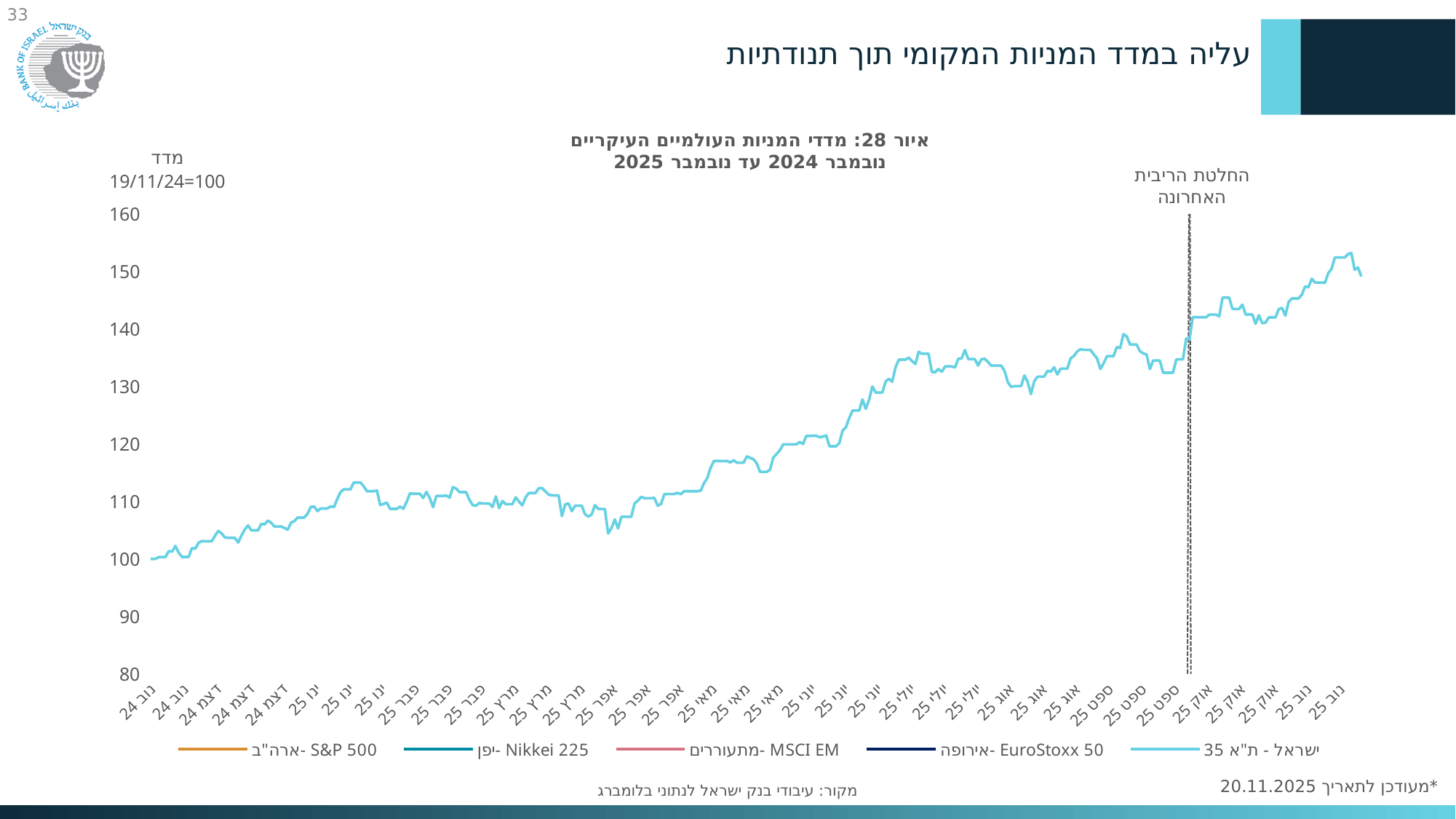
What kind of chart is shown on the slide? line chart Is the value of the ת"א 35 index in ספט 25 greater or less than 130? greater In which month does the ת"א 35 index reach its highest value? נוב 25 Is the value of the ת"א 35 index in אפר 25 greater or less than 120? less Is the value of the ת"א 35 index in אוג 25 greater or less than 120? greater Does the ת"א 35 index rise or fall overall from נוב 24 to נוב 25? rise In which month does the ת"א 35 index reach its lowest value? נוב 24 Which series is plotted as the light blue line? ישראל - ת"א 35 What is the base value of the index, as stated above the y axis? 19/11/24=100 How many series does the legend list? 5